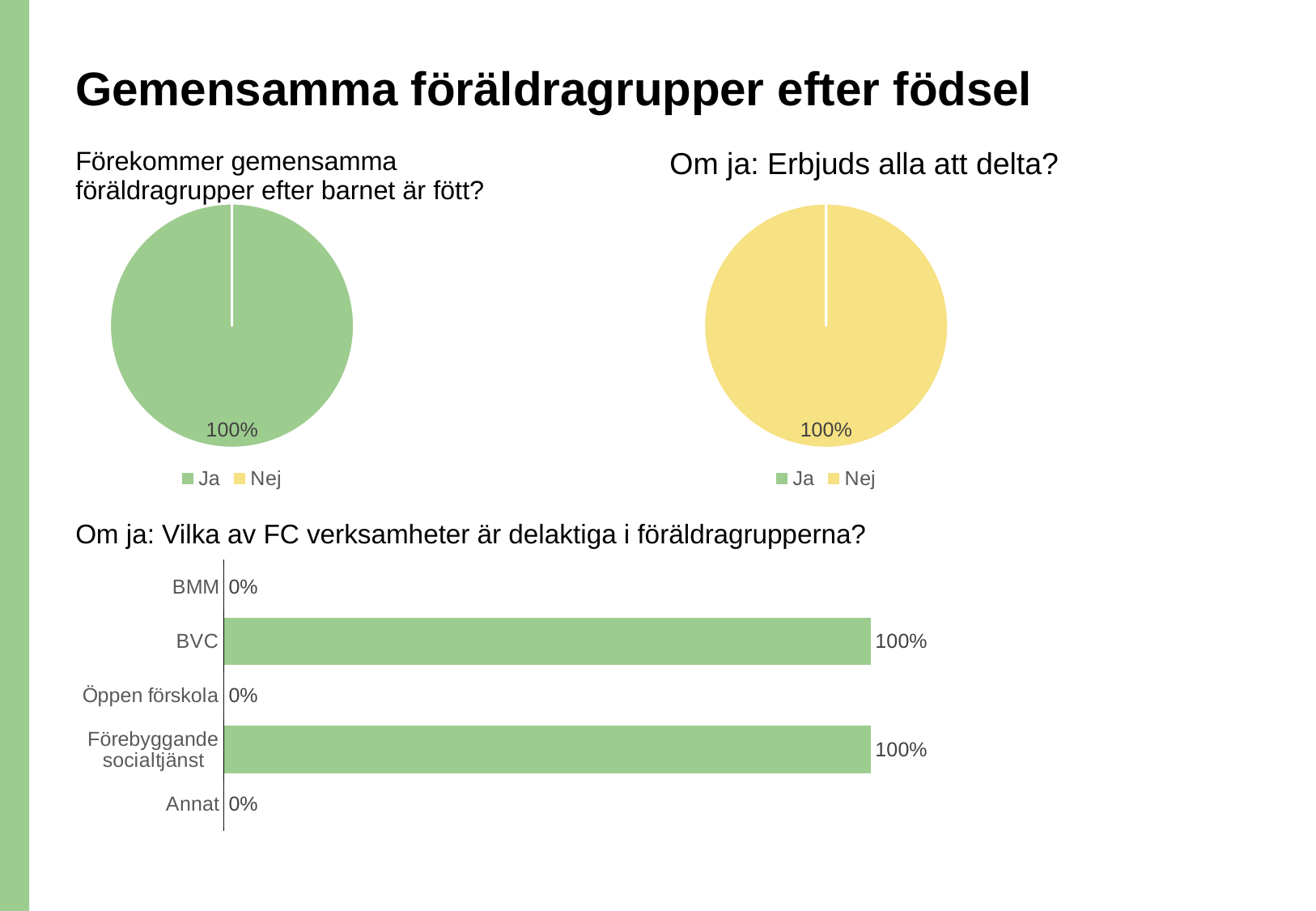
In the bar chart titled 'Om ja: Vilka av FC verksamheter är delaktiga i föräldragrupperna?', how many categories are shown? 5 In the bar chart titled 'Om ja: Vilka av FC verksamheter är delaktiga i föräldragrupperna?', what is the value for Förebyggande socialtjänst? 100% What kind of chart is the chart titled 'Om ja: Vilka av FC verksamheter är delaktiga i föräldragrupperna?' Bar chart In the bar chart titled 'Om ja: Vilka av FC verksamheter är delaktiga i föräldragrupperna?', what is the value for Öppen förskola? 0% In the pie chart titled 'Förekommer gemensamma föräldragrupper efter barnet är fött?', what share does the 'Ja' slice have? 100% In the bar chart titled 'Om ja: Vilka av FC verksamheter är delaktiga i föräldragrupperna?', what is the difference between the values for BVC and Annat? 100% What colour is the 'Ja' slice in the pie chart titled 'Förekommer gemensamma föräldragrupper efter barnet är fött?' Green In the pie chart titled 'Om ja: Erbjuds alla att delta?', which legend entry does the single slice correspond to? Nej How many series does the legend list for the pie chart titled 'Förekommer gemensamma föräldragrupper efter barnet är fött?' 2 In the bar chart titled 'Om ja: Vilka av FC verksamheter är delaktiga i föräldragrupperna?', what is the value for BVC? 100% In the pie chart titled 'Om ja: Erbjuds alla att delta?', what share does the 'Nej' slice have? 100% In the bar chart titled 'Om ja: Vilka av FC verksamheter är delaktiga i föräldragrupperna?', which is larger, BVC or BMM? BVC